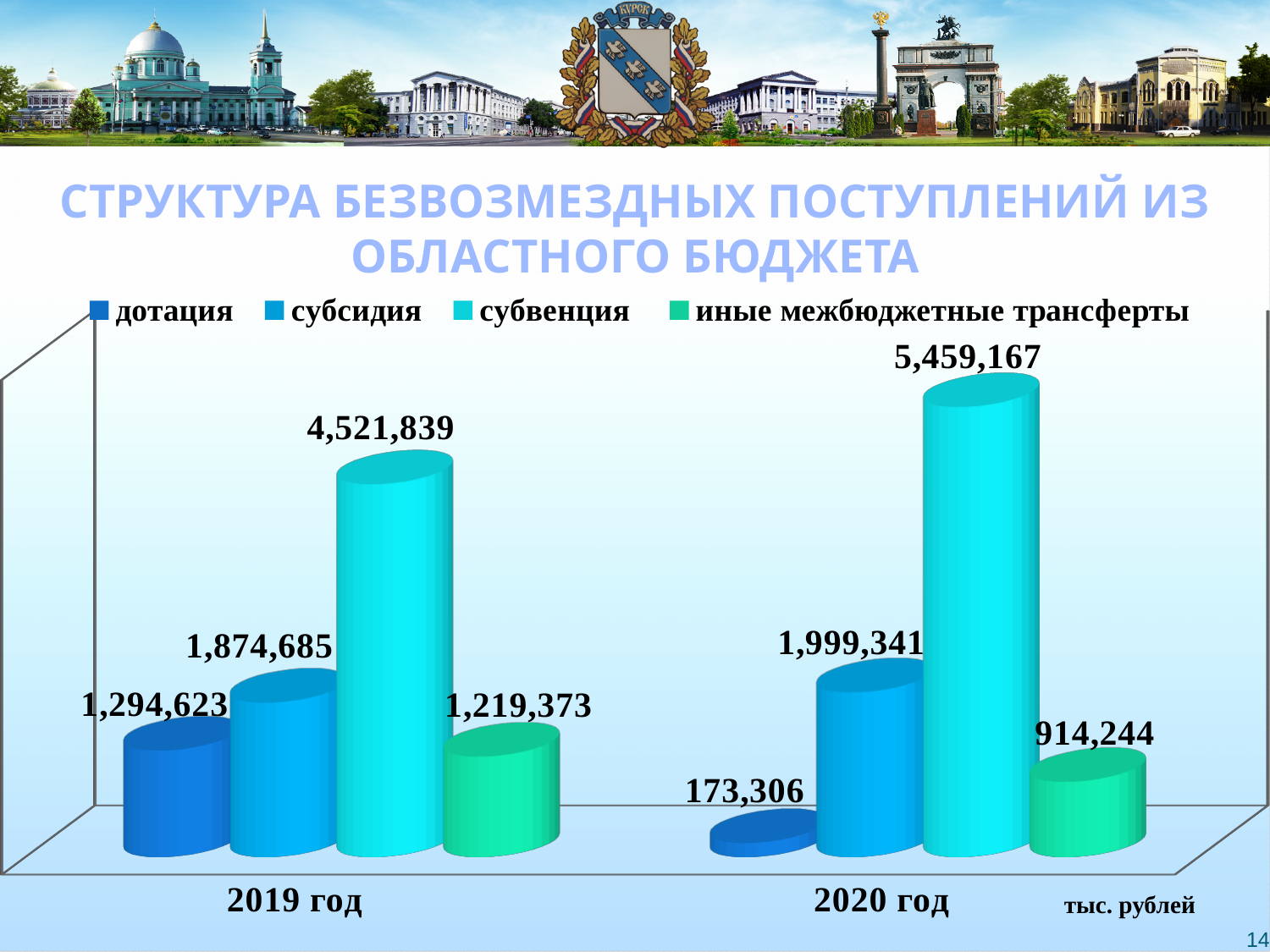
How many series does the legend list? 4 Which is larger: субсидия in 2019 год or субсидия in 2020 год? субсидия in 2020 год What is the difference between the дотация values for 2019 год and 2020 год? 1,121,317 What is the value for дотация in 2020 год? 173,306 What is the difference between the субвенция values for 2020 год and 2019 год? 937,328 What is the value for иные межбюджетные трансферты in 2019 год? 1,219,373 Which series has the highest value in 2020 год? субвенция What is the value for субвенция in 2019 год? 4,521,839 What unit is indicated at the bottom right of the chart? тыс. рублей Which series has the lowest value in 2020 год? дотация What is the value for субсидия in 2020 год? 1,999,341 What kind of chart is shown on the slide? bar chart